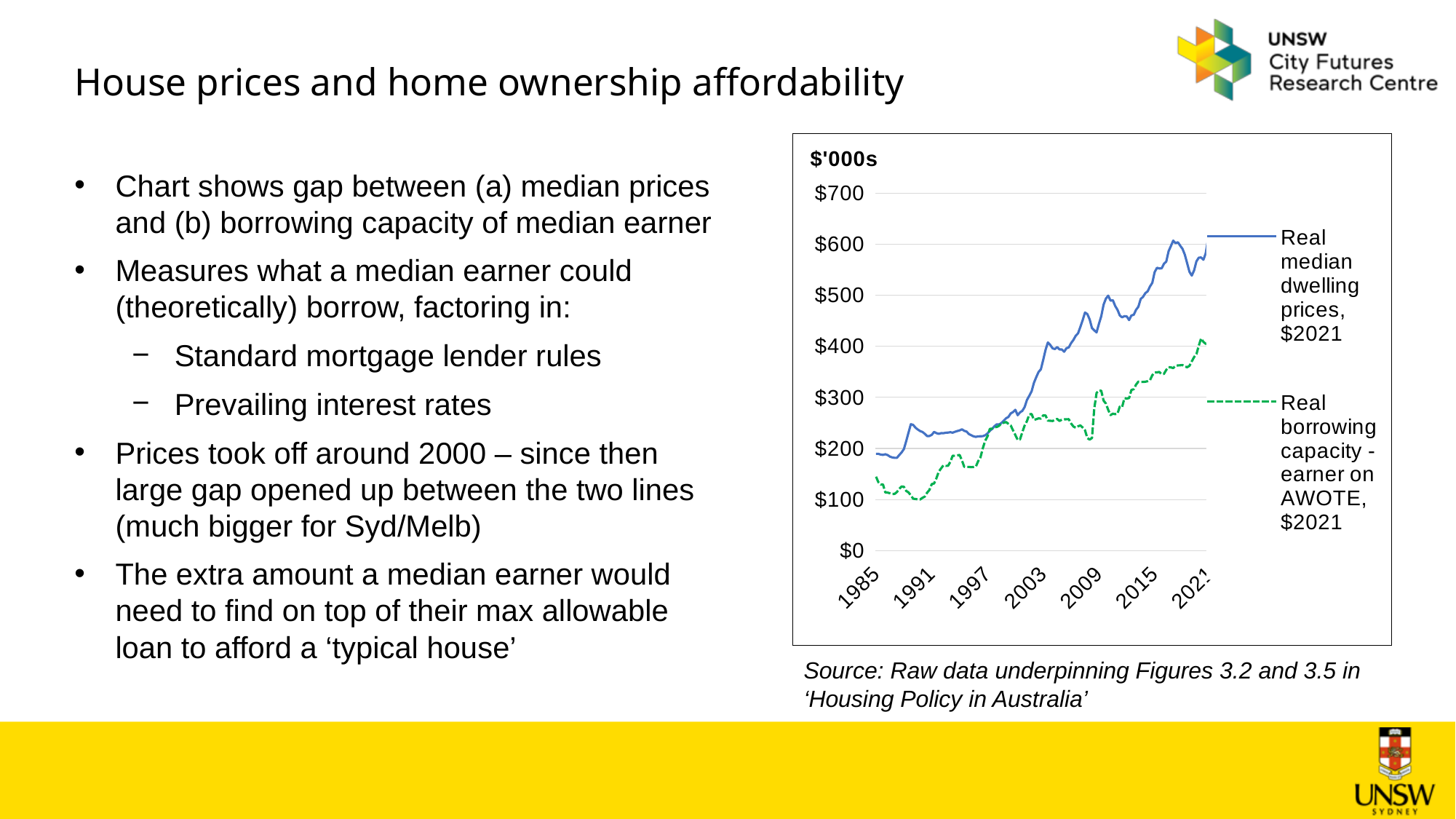
Is the value of Real borrowing capacity in 2021 greater or less than $500? less Does the Real median dwelling prices line rise or fall between 2003 and 2021? rise Is the value of Real borrowing capacity in 1985 greater or less than $200? less What unit label is shown at the top of the chart's y axis? $'000s How many year labels are shown on the chart's x axis? 7 Is the value of Real median dwelling prices in 1985 greater or less than $300? less How many series does the chart's legend list? 2 What type of chart is shown on the slide? Line chart Which series is drawn as a green dashed line? Real borrowing capacity - earner on AWOTE, $2021 In 2021, which series has the higher value: Real median dwelling prices or Real borrowing capacity? Real median dwelling prices Does the Real borrowing capacity line rise or fall overall from 1985 to 2021? rise